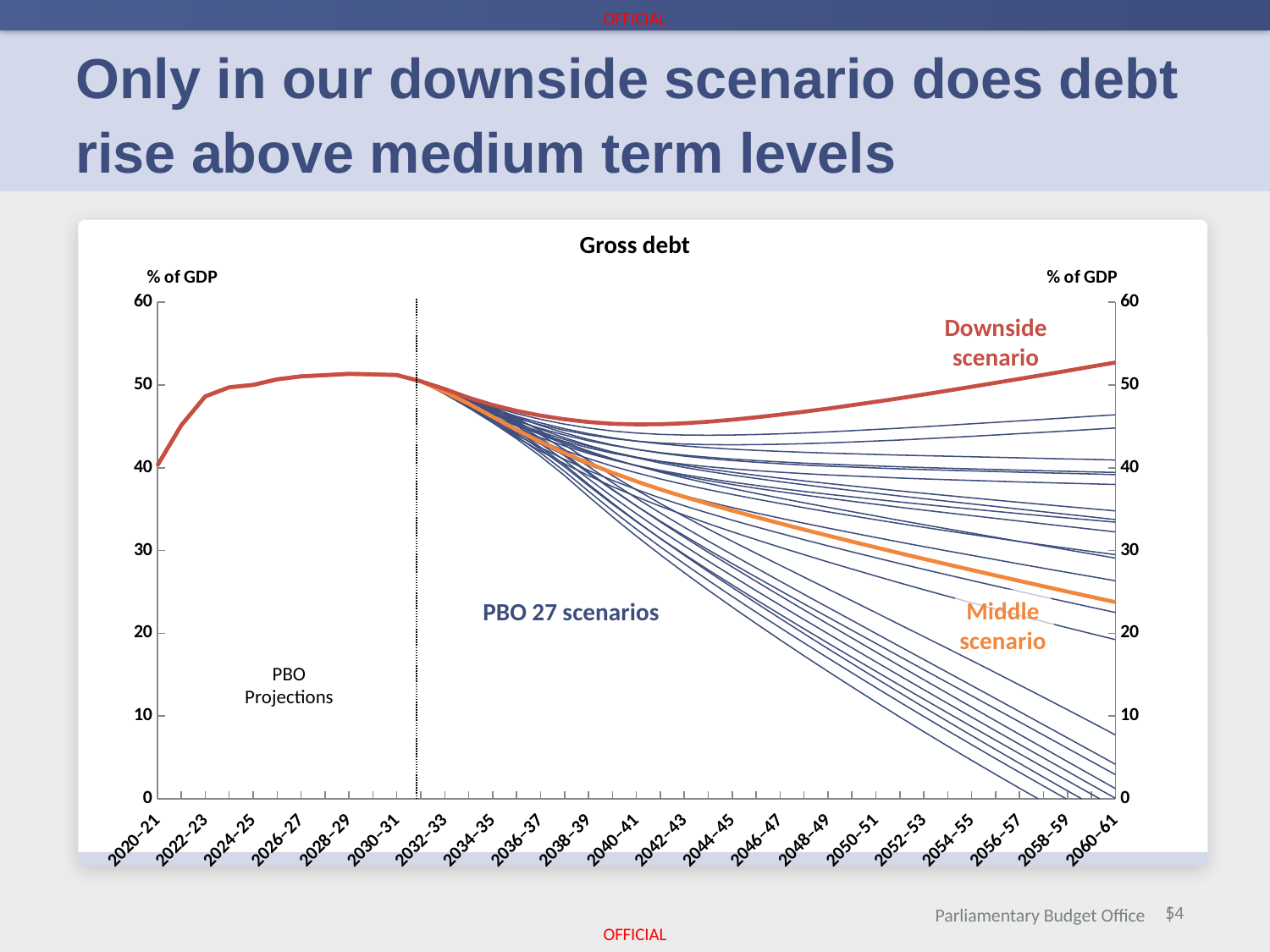
Is the value of the Middle scenario in 2060-61 greater or less than 30? less Does the Downside scenario line rise or fall between 2040-41 and 2060-61? rise Is the value of the Downside scenario in 2040-41 greater or less than 40? greater Which scenario has the higher gross debt in 2060-61, the Downside scenario or the Middle scenario? Downside scenario Is the value of the Downside scenario in 2060-61 greater or less than 50? greater What is the title of the chart? Gross debt How many PBO scenarios does the chart say are plotted as thin blue lines? 27 In what unit is the y axis of the chart expressed? % of GDP Does the Middle scenario line rise or fall between 2032-33 and 2060-61? fall What kind of chart is shown on the slide? line chart